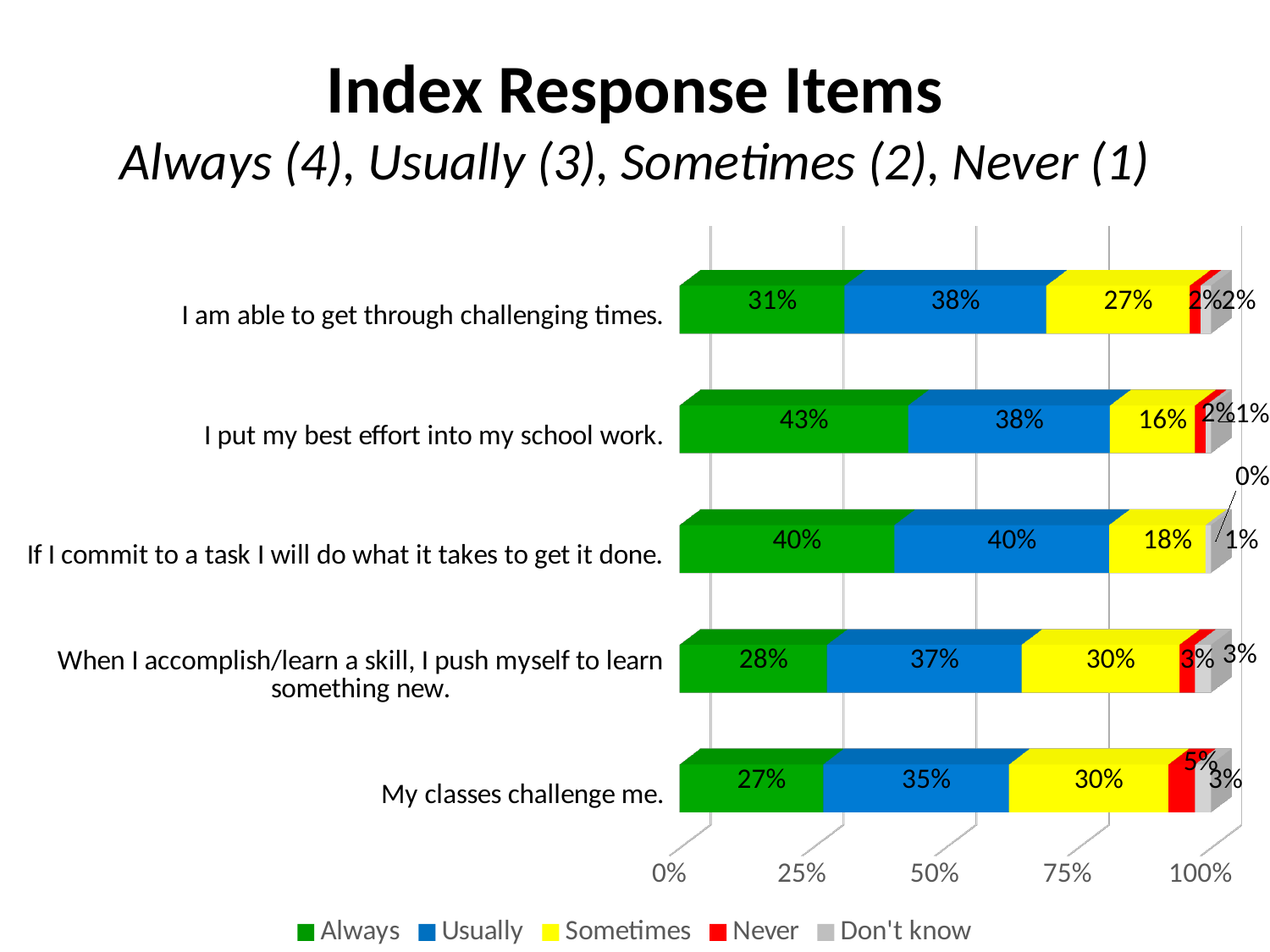
What is the difference between the 'Sometimes' values for 'I am able to get through challenging times.' and 'I put my best effort into my school work.'? 11% What colour represents the 'Sometimes' series in the legend? yellow What is the 'Sometimes' value for 'My classes challenge me.'? 30% What kind of chart is shown on the slide? stacked bar chart Which is larger: the 'Never' value for 'My classes challenge me.' or the 'Never' value for 'When I accomplish/learn a skill, I push myself to learn something new.'? My classes challenge me. What is the 'Always' value for 'I put my best effort into my school work.'? 43% Which item has the lowest 'Always' value? My classes challenge me. How many response items (categories) are plotted in the chart? 5 What is the 'Usually' value for 'I am able to get through challenging times.'? 38% What is the 'Never' value for 'If I commit to a task I will do what it takes to get it done.'? 0% How many series does the legend list? 5 Which item has the highest 'Always' value? I put my best effort into my school work.